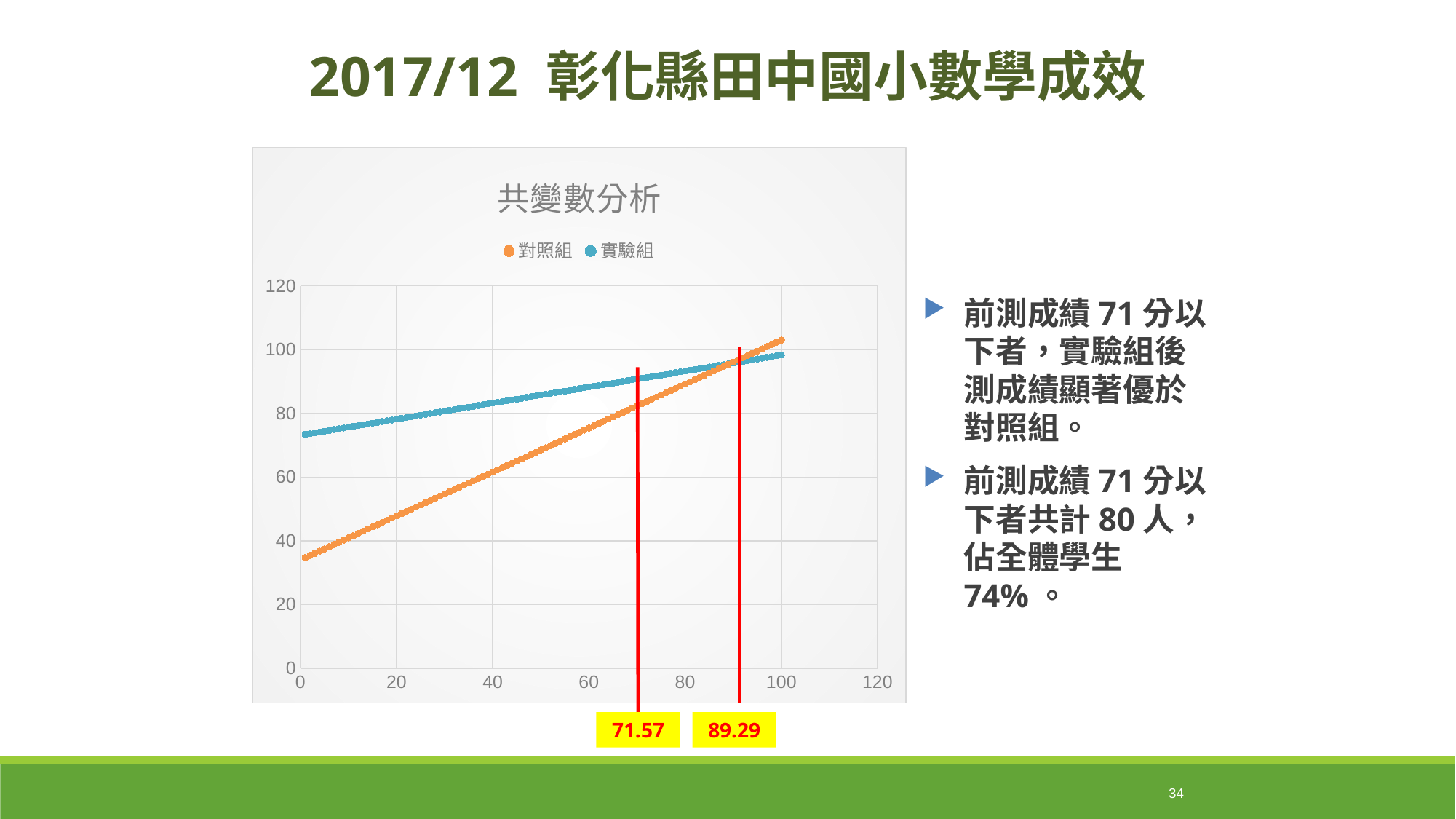
At x = 20, which series has the higher value, 對照組 or 實驗組? 實驗組 What is the title of the chart? 共變數分析 At x = 100, which series has the higher value, 對照組 or 實驗組? 對照組 Do the values for 實驗組 rise or fall as the x axis increases? rise How many series does the chart legend list? 2 Is the value for 實驗組 at x = 0 greater or less than 60? greater Is the value for 實驗組 at x = 100 greater or less than 100? less Which series is shown in orange in the chart? 對照組 What x value is labelled at the left red vertical line below the chart? 71.57 Is the value for 對照組 at x = 0 greater or less than 40? less Do the values for 對照組 rise or fall as the x axis increases? rise What x value is labelled at the right red vertical line below the chart? 89.29